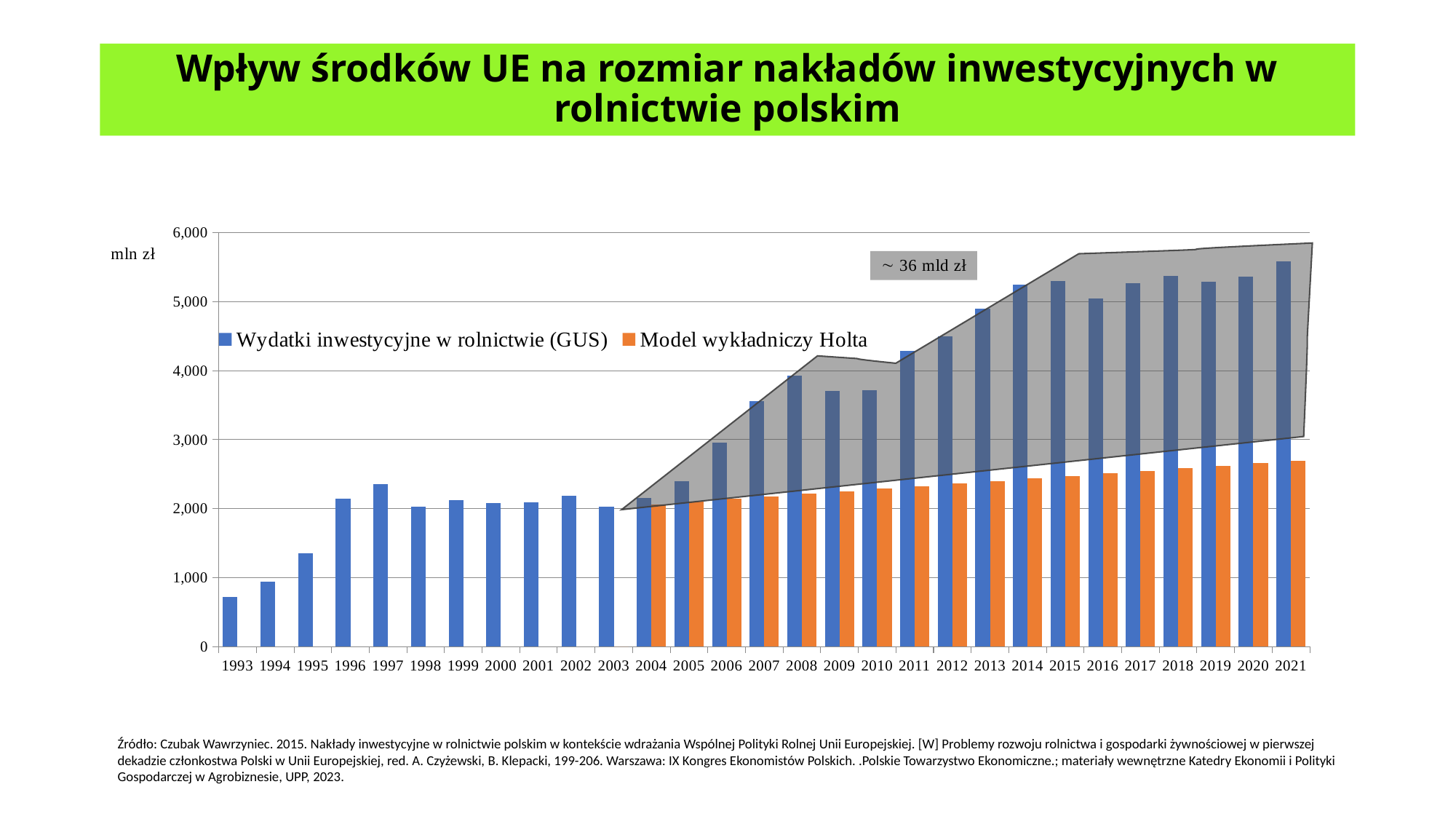
Is the value for 'Wydatki inwestycyjne w rolnictwie (GUS)' in 2021 greater or less than 5,000? greater In 2021, which series has the larger value: 'Wydatki inwestycyjne w rolnictwie (GUS)' or 'Model wykładniczy Holta'? Wydatki inwestycyjne w rolnictwie (GUS) What kind of chart is shown on the slide? bar chart In which year is the value of 'Model wykładniczy Holta' the highest? 2021 In which year is the value of 'Wydatki inwestycyjne w rolnictwie (GUS)' the highest? 2021 How many series does the chart legend list? 2 Do the values of 'Model wykładniczy Holta' rise or fall from 2004 to 2021? rise How many years are shown on the x axis of the chart? 29 Is the value for 'Wydatki inwestycyjne w rolnictwie (GUS)' in 1993 greater or less than 1,000? less In which year is the value of 'Wydatki inwestycyjne w rolnictwie (GUS)' the lowest? 1993 Is the value for 'Model wykładniczy Holta' in 2021 greater or less than 3,000? less What unit is shown on the y axis label of the chart? mln zł